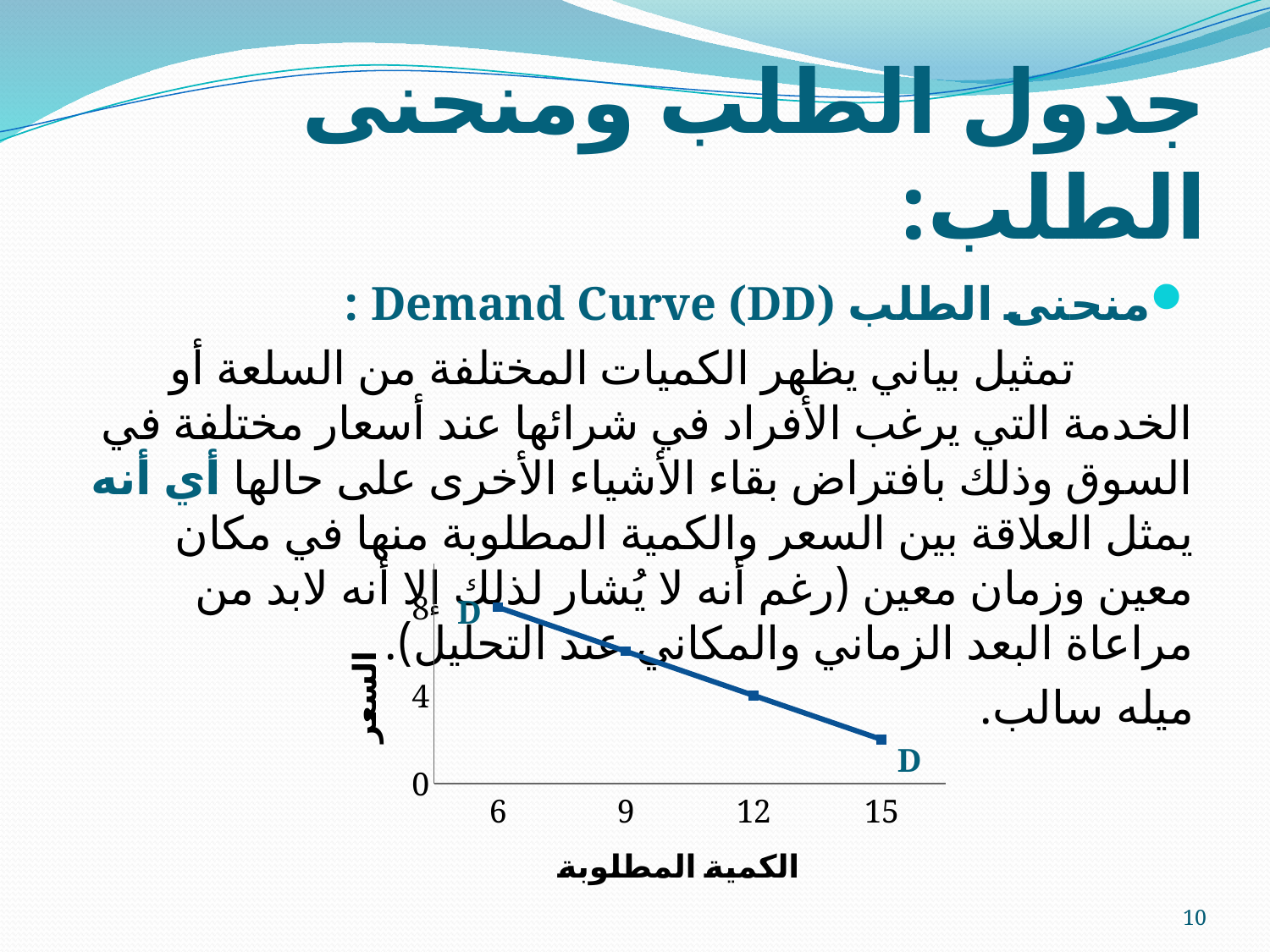
Which quantity demanded has the lowest price value? 15 What is the price value at a quantity demanded of 6? 8 Is the value at a quantity demanded of 15 greater or less than 4? less Which has a larger price value: quantity demanded 6 or quantity demanded 15? 6 What letter labels the two ends of the curve? D Do the values rise or fall as the quantity demanded increases along the x axis? fall Is the value at a quantity demanded of 9 greater or less than 4? greater Which quantity demanded has the highest price value? 6 How many data points are plotted on the demand curve? 4 What kind of chart is shown on the slide? line chart What is the title of the x axis? الكمية المطلوبة What is the price value at a quantity demanded of 12? 4